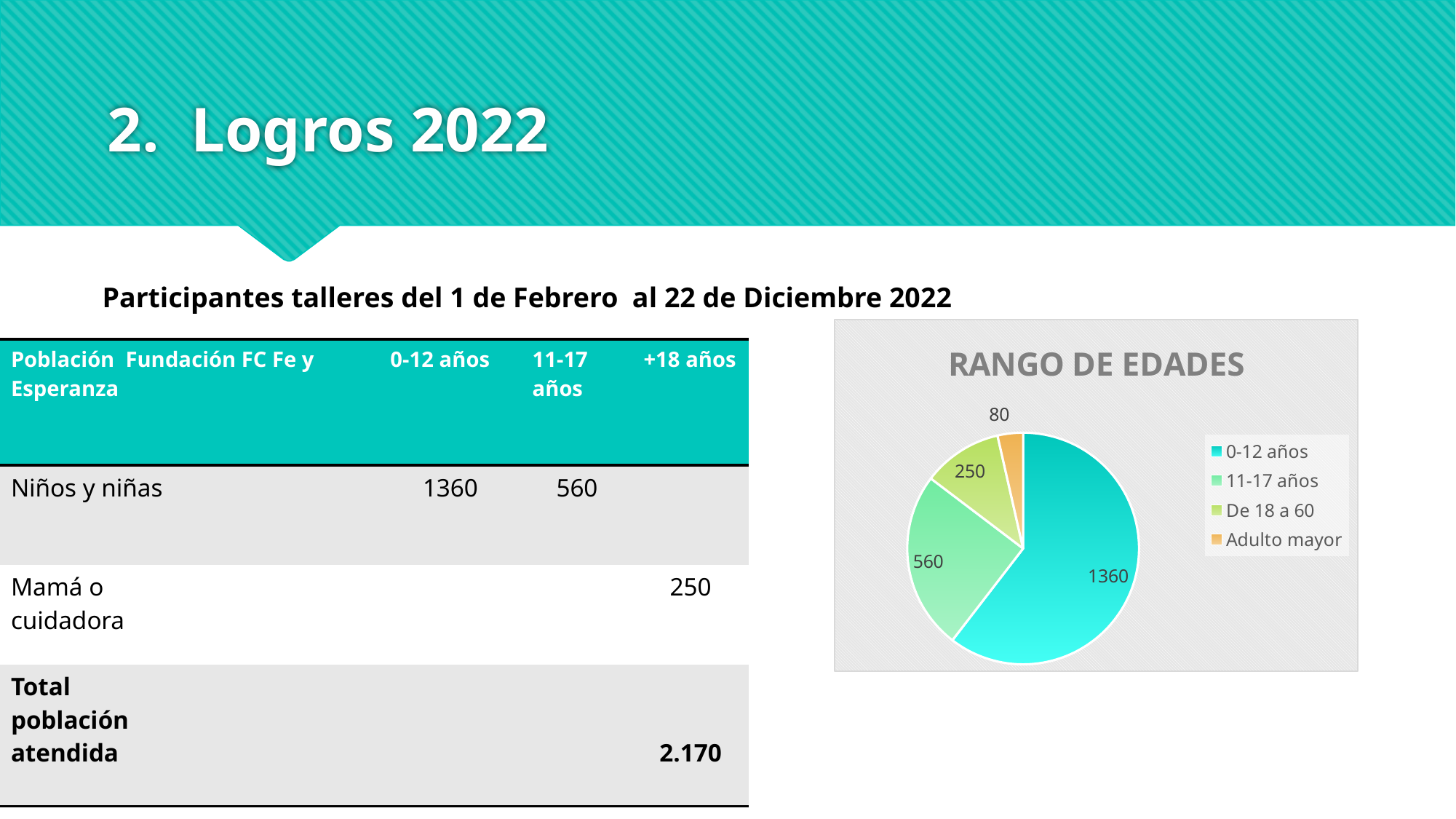
What is the title of the chart on the slide? RANGO DE EDADES In the RANGO DE EDADES pie chart, what is the difference between the 0-12 años and 11-17 años values? 800 In the RANGO DE EDADES pie chart, what is the difference between the De 18 a 60 and Adulto mayor values? 170 What is the value of the 0-12 años slice in the RANGO DE EDADES pie chart? 1360 What is the value of the De 18 a 60 slice in the RANGO DE EDADES pie chart? 250 Which age range has the smallest slice in the RANGO DE EDADES pie chart? Adulto mayor What is the value of the Adulto mayor slice in the RANGO DE EDADES pie chart? 80 How many slices does the RANGO DE EDADES pie chart have? 4 What type of chart is RANGO DE EDADES? Pie chart What is the value of the 11-17 años slice in the RANGO DE EDADES pie chart? 560 Which age range has the largest slice in the RANGO DE EDADES pie chart? 0-12 años In the RANGO DE EDADES pie chart, which is larger: 11-17 años or De 18 a 60? 11-17 años